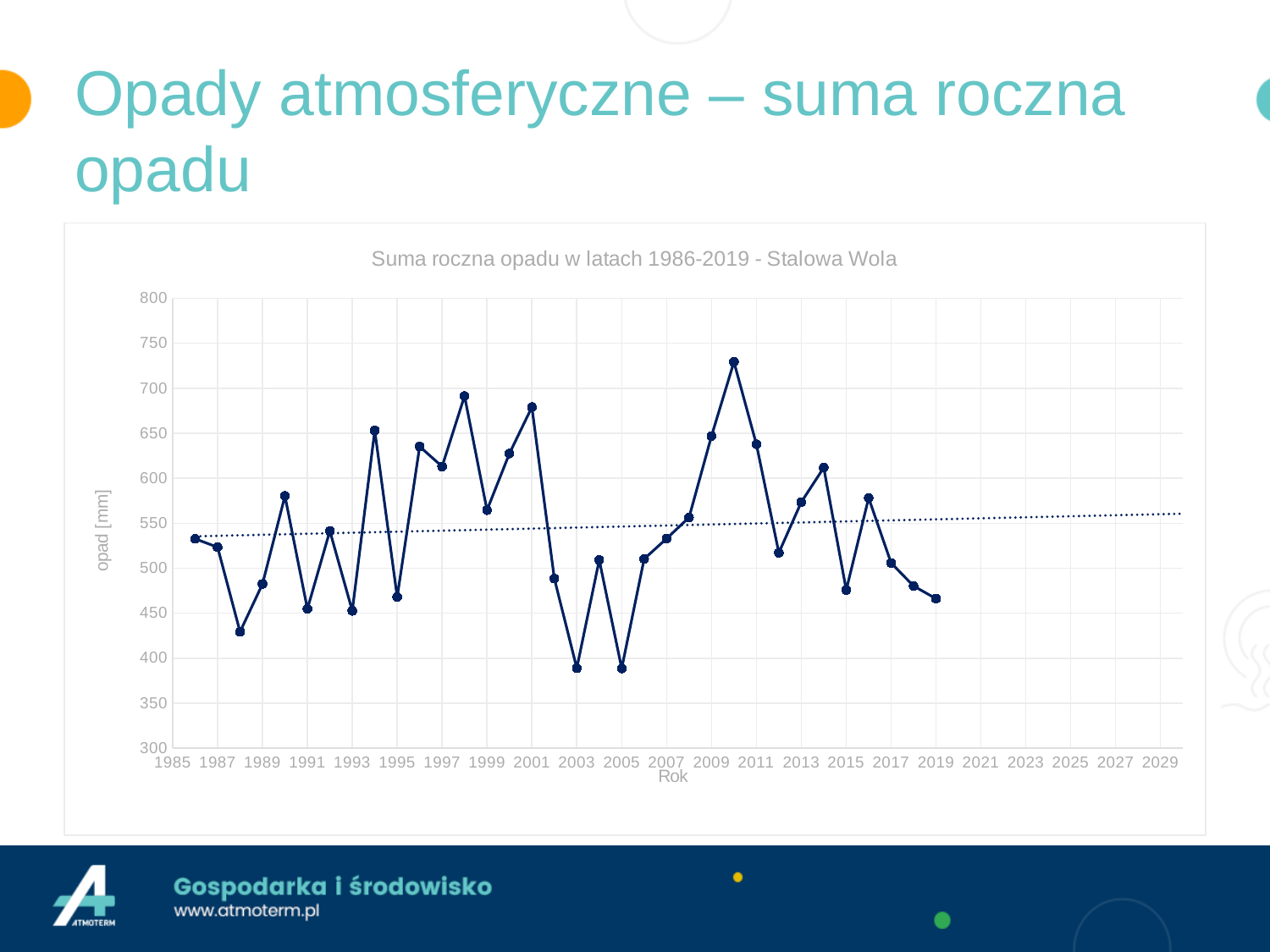
How many yearly data points are plotted on the chart? 34 Is the value for 2019 greater or less than 500? less Is the value for 1998 greater or less than 650? greater In which year is the annual precipitation sum highest? 2010 What kind of chart is shown on the slide? line chart Is the value for 1988 greater or less than 450? less What is the title of the chart? Suma roczna opadu w latach 1986-2019 - Stalowa Wola Which year has the larger value, 1994 or 1995? 1994 Which year has the larger value, 2010 or 2019? 2010 What is the label of the vertical axis? opad [mm]